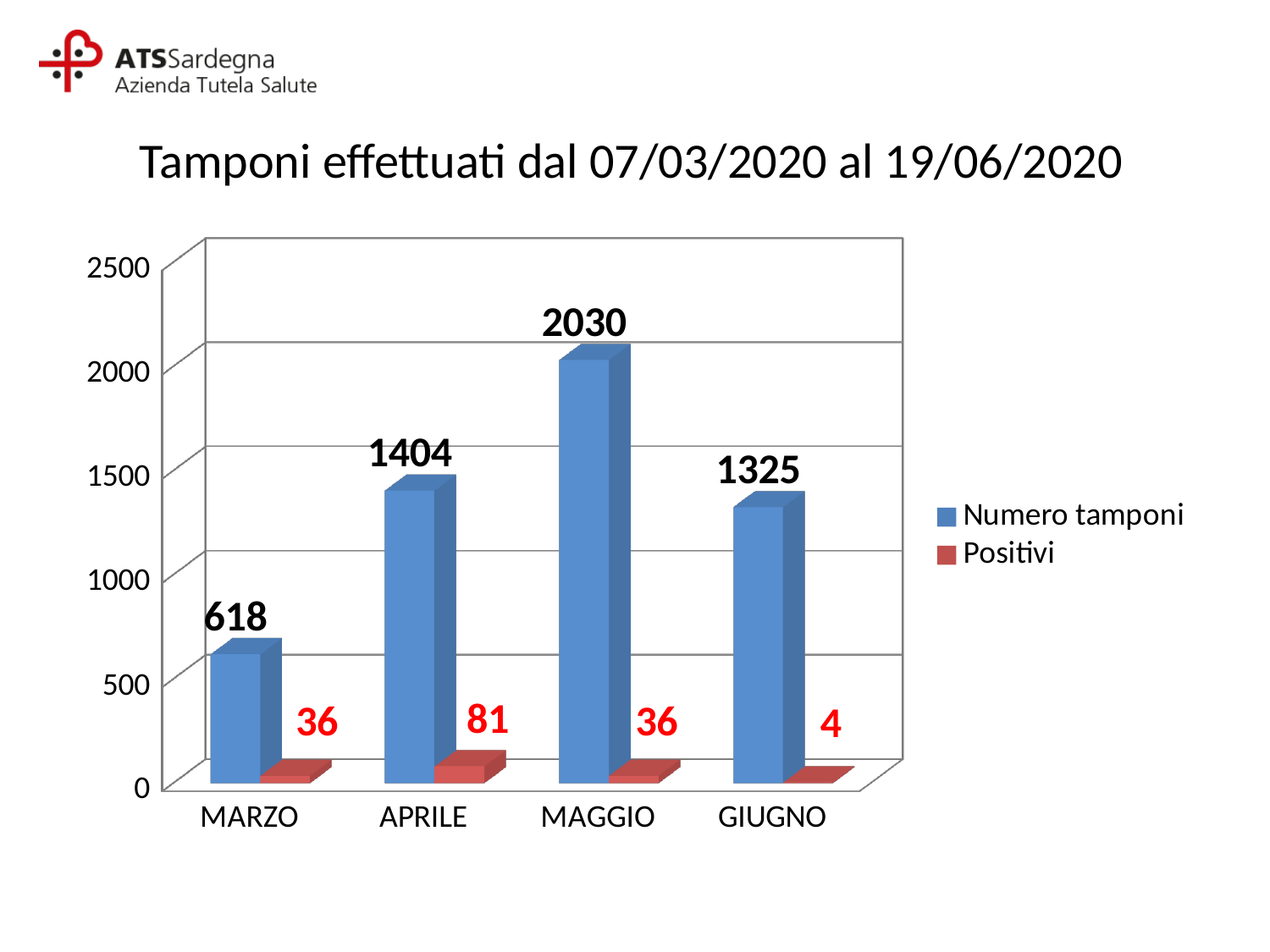
What kind of chart is shown on the slide? bar chart How many months are shown on the x axis? 4 What is the value of Numero tamponi for GIUGNO? 1325 Which month has the lowest Positivi value? GIUGNO Is the value of Numero tamponi for MARZO greater or less than 1000? less What is the value of Numero tamponi for MAGGIO? 2030 What is the title of the chart? Tamponi effettuati dal 07/03/2020 al 19/06/2020 Which is larger, Numero tamponi for APRILE or for GIUGNO? APRILE Which month has the highest Numero tamponi? MAGGIO What is the value of Positivi for APRILE? 81 What is the difference between Numero tamponi for MAGGIO and APRILE? 626 How many series does the legend list? 2